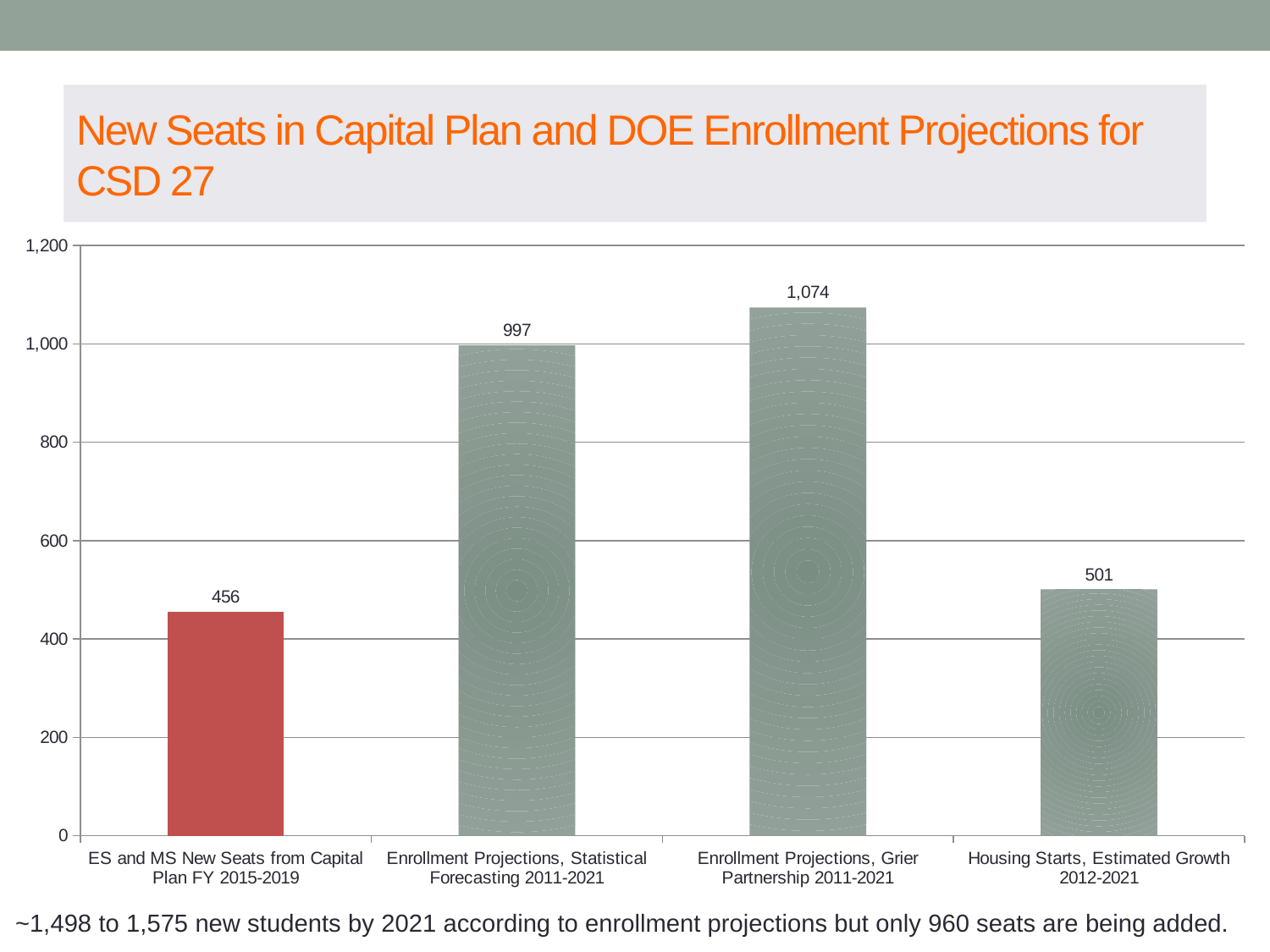
How many categories are shown in the chart? 4 What is the value for Enrollment Projections, Statistical Forecasting 2011-2021? 997 What is the difference between the Grier Partnership projection and the Statistical Forecasting projection? 77 Which bar is coloured red rather than grey-green? ES and MS New Seats from Capital Plan FY 2015-2019 What is the value for Housing Starts, Estimated Growth 2012-2021? 501 What is the value for ES and MS New Seats from Capital Plan FY 2015-2019? 456 What is the value for Enrollment Projections, Grier Partnership 2011-2021? 1,074 Which category has the highest value? Enrollment Projections, Grier Partnership 2011-2021 What kind of chart is shown on the slide? Bar chart What is the difference between Housing Starts, Estimated Growth 2012-2021 and ES and MS New Seats from Capital Plan FY 2015-2019? 45 Which category has the lowest value? ES and MS New Seats from Capital Plan FY 2015-2019 Which is larger: Enrollment Projections, Statistical Forecasting 2011-2021 or Housing Starts, Estimated Growth 2012-2021? Enrollment Projections, Statistical Forecasting 2011-2021